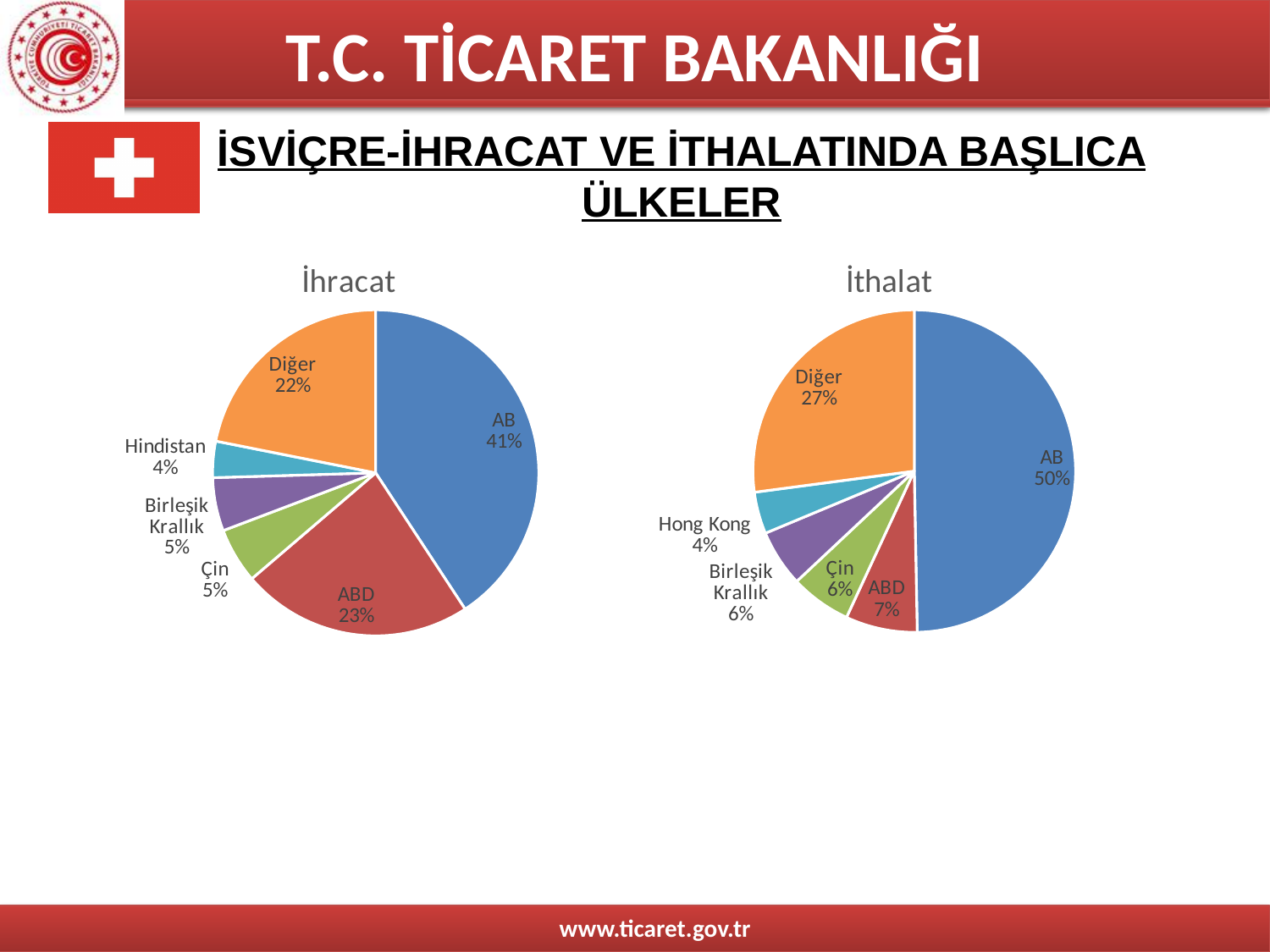
In the İthalat chart, what share does ABD have? 7% In the İhracat chart, which category has the largest share? AB In the İhracat chart, what share does Hindistan have? 4% In the İthalat chart, which is larger, the share of Diğer or the share of ABD? Diğer How many slices does the İhracat chart have? 6 What kind of chart is the İthalat chart? Pie chart In the İthalat chart, what is the difference between the shares of AB and Diğer? 23% In the İthalat chart, what share does Birleşik Krallık have? 6% What is the title of the chart on the left? İhracat In the İthalat chart, which category has the smallest share? Hong Kong In the İhracat chart, what is the difference between the shares of AB and ABD? 18% In the İhracat chart, what share does AB have? 41%